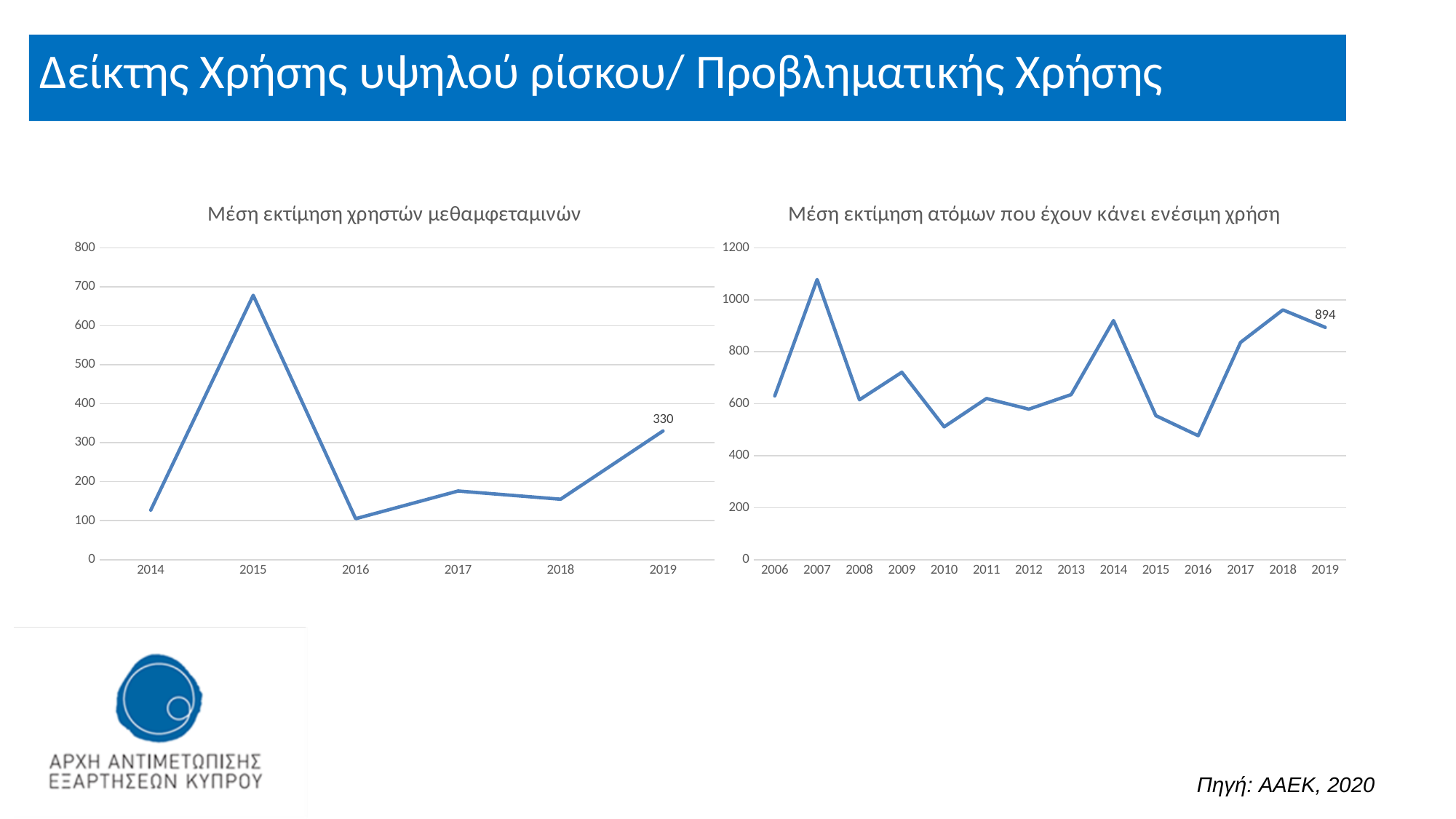
In the left chart (Μέση εκτίμηση χρηστών μεθαμφεταμινών), which year has the highest value? 2015 In the right chart (Μέση εκτίμηση ατόμων που έχουν κάνει ενέσιμη χρήση), is the value for 2007 greater or less than 1000? greater In the chart titled 'Μέση εκτίμηση ατόμων που έχουν κάνει ενέσιμη χρήση', what is the value for 2019? 894 What type of chart is the left chart (Μέση εκτίμηση χρηστών μεθαμφεταμινών)? Line chart In the right chart (Μέση εκτίμηση ατόμων που έχουν κάνει ενέσιμη χρήση), is the value for 2016 greater or less than 600? less In the left chart (Μέση εκτίμηση χρηστών μεθαμφεταμινών), is the value for 2015 greater or less than 600? greater In the right chart (Μέση εκτίμηση ατόμων που έχουν κάνει ενέσιμη χρήση), which year has the larger value, 2018 or 2019? 2018 How many years are plotted in the left chart (Μέση εκτίμηση χρηστών μεθαμφεταμινών)? 6 How many years are plotted in the right chart (Μέση εκτίμηση ατόμων που έχουν κάνει ενέσιμη χρήση)? 14 In the chart titled 'Μέση εκτίμηση χρηστών μεθαμφεταμινών', what is the value for 2019? 330 In the right chart (Μέση εκτίμηση ατόμων που έχουν κάνει ενέσιμη χρήση), which year has the highest value? 2007